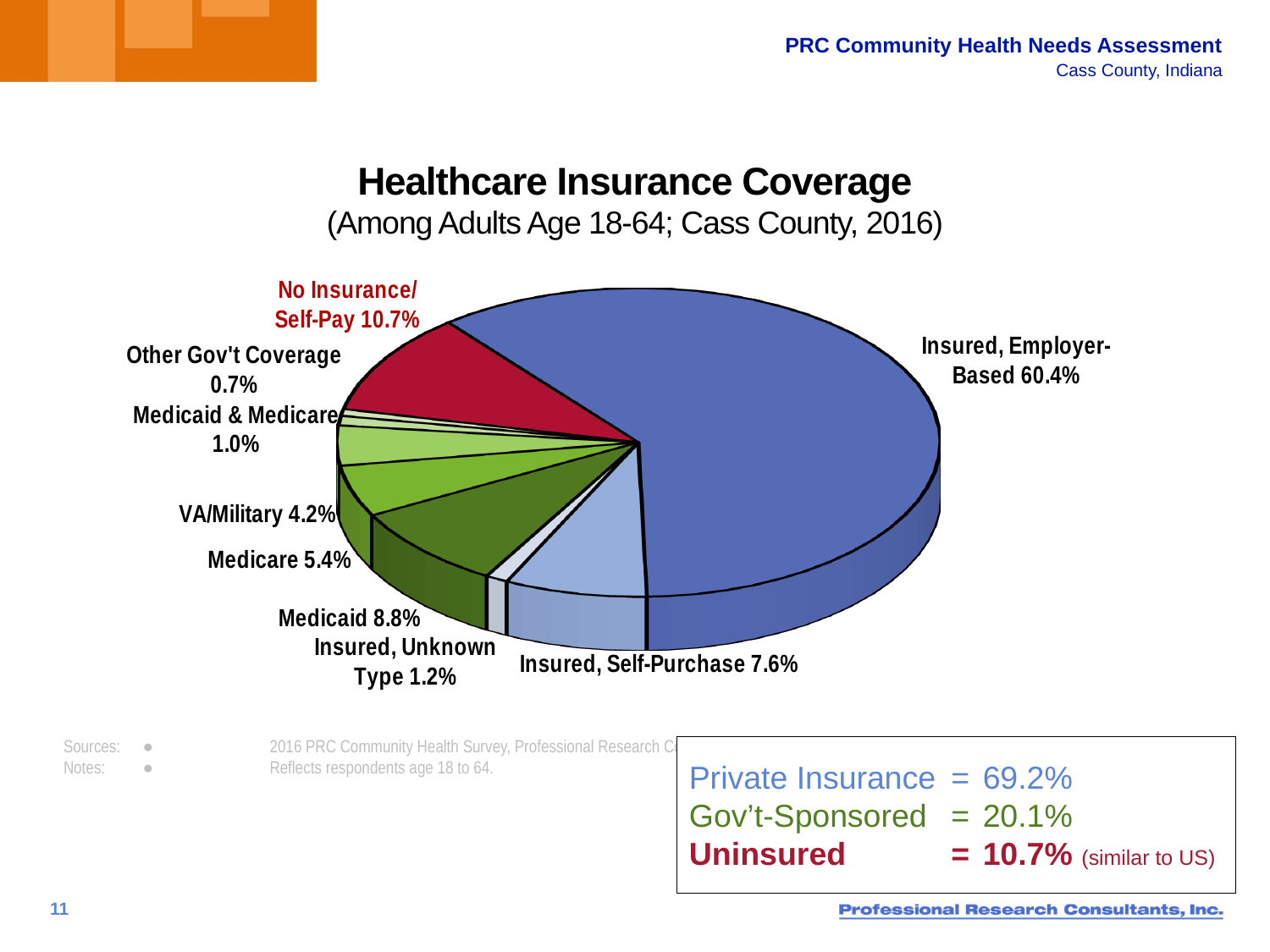
What is the value for Medicaid? 8.8% Which category has the largest share of the pie? Insured, Employer-Based What is the value for VA/Military? 4.2% What is the difference between Insured, Self-Purchase and Medicare? 2.2% What is the value for Insured, Unknown Type? 1.2% What type of chart is shown on the slide? Pie chart What is the value for No Insurance/Self-Pay? 10.7% How many categories are shown in the pie chart? 9 Which category has the smallest share of the pie? Other Gov't Coverage What is the title of the chart? Healthcare Insurance Coverage What is the value for Insured, Employer-Based? 60.4% Which is larger, Medicaid or Medicare? Medicaid